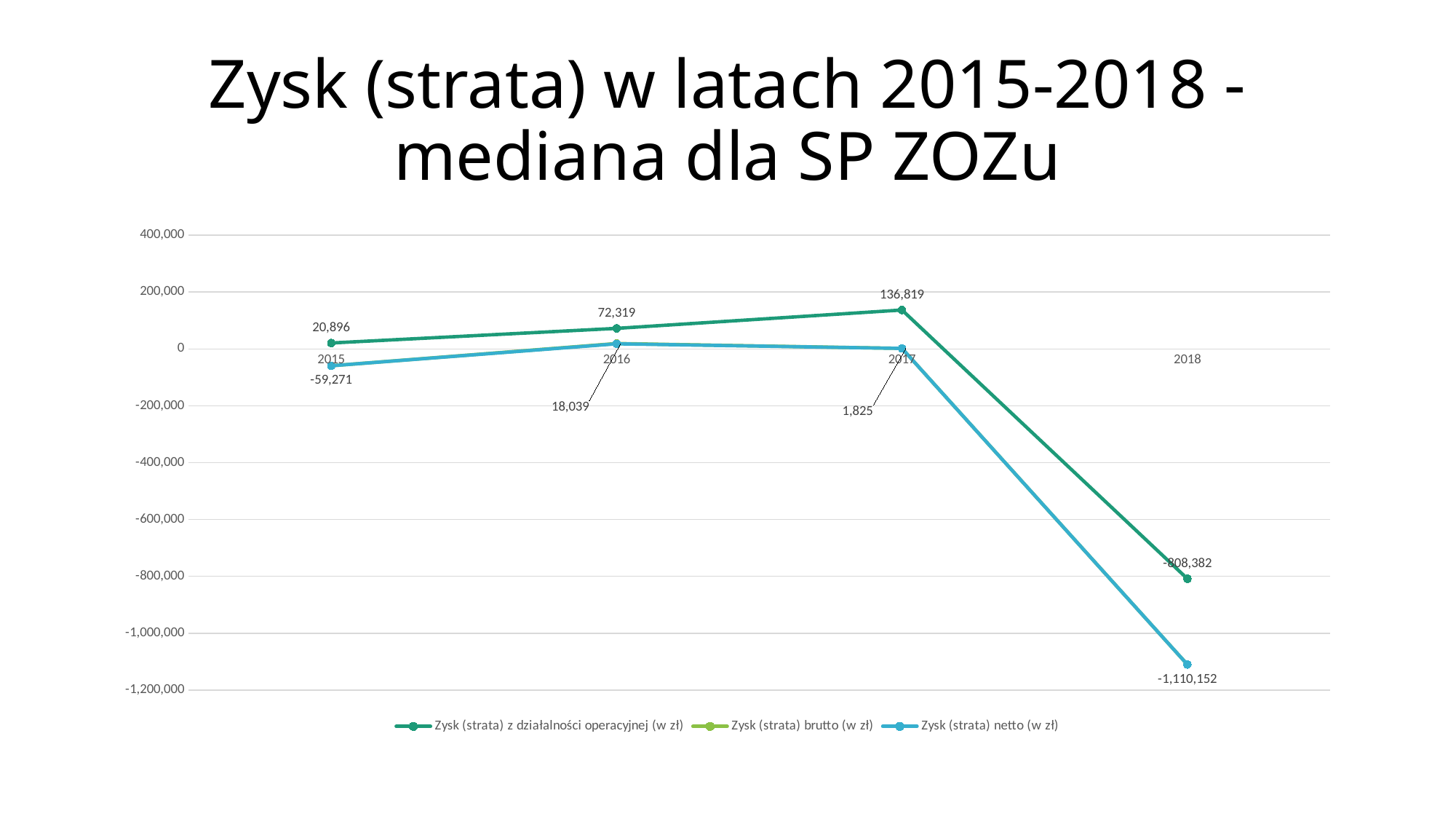
How many years are plotted along the x axis? 4 What is the value of Zysk (strata) z działalności operacyjnej in 2017? 136,819 What is the difference between Zysk (strata) z działalności operacyjnej in 2017 and in 2016? 64,500 In which year is Zysk (strata) z działalności operacyjnej highest? 2017 What kind of chart is shown on the slide? line chart Is the value of Zysk (strata) z działalności operacyjnej in 2018 greater or less than -600,000? less In which year is Zysk (strata) z działalności operacyjnej lowest? 2018 What is the lowest value labelled on the chart? -1,110,152 What is the value of Zysk (strata) z działalności operacyjnej in 2015? 20,896 How many series does the legend list? 3 Does Zysk (strata) z działalności operacyjnej rise or fall from 2015 to 2017? rise What is the value of Zysk (strata) z działalności operacyjnej in 2018? -808,382